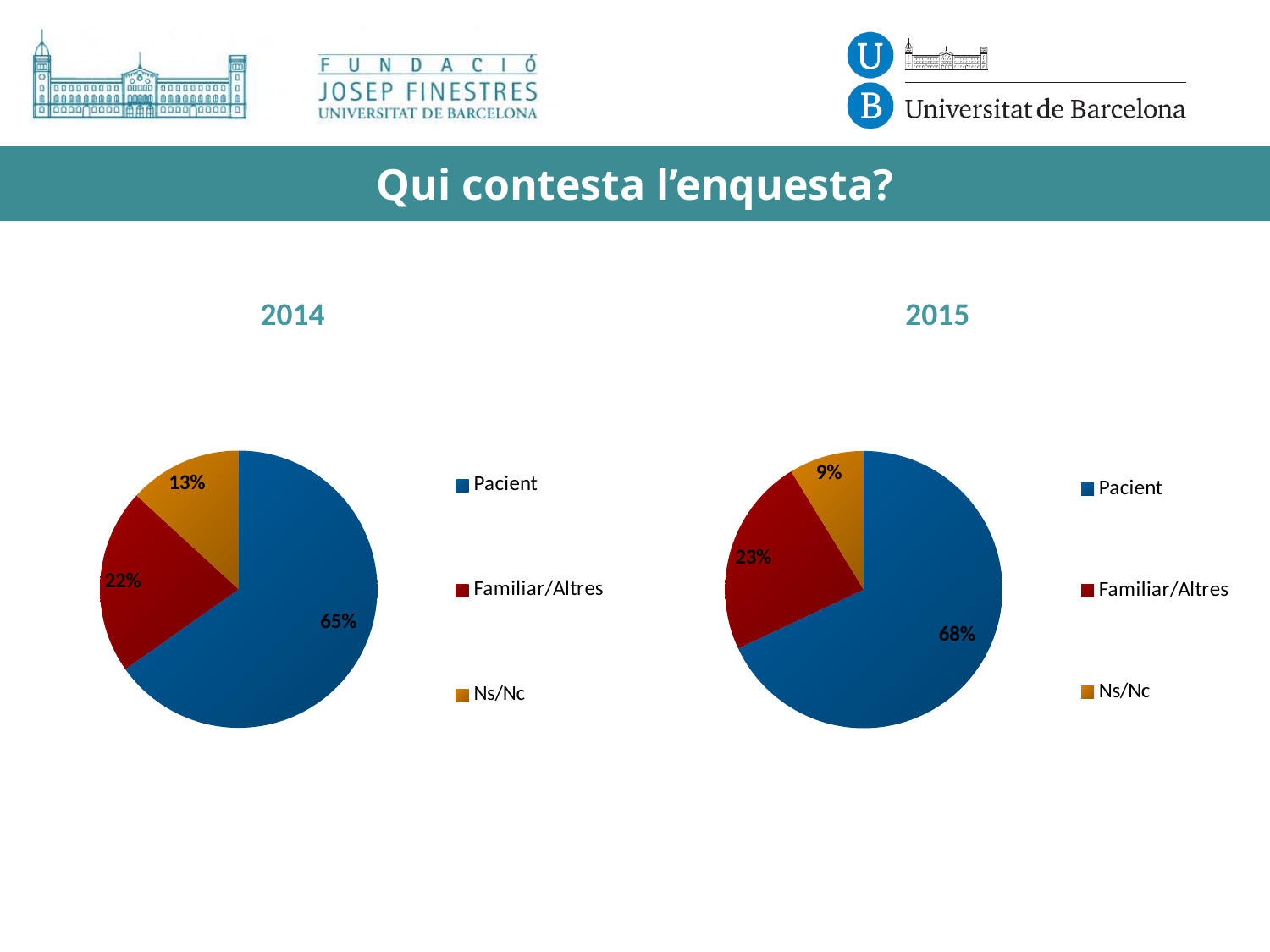
In the 2014 chart, what share of respondents is Ns/Nc? 13% How many categories does the 2015 chart show? 3 In the 2015 chart, what share of respondents is Ns/Nc? 9% Is the Ns/Nc share larger in the 2014 chart or the 2015 chart? 2014 In the 2014 chart, what is the difference between the Familiar/Altres share and the Ns/Nc share? 9% In the 2014 chart, which category has the smallest slice? Ns/Nc What kind of chart is used for the 2014 data? Pie chart In the 2014 chart, what share of respondents is Pacient? 65% What is the difference between the Pacient share in the 2015 chart and the Pacient share in the 2014 chart? 3% In the 2014 chart, which colour represents Familiar/Altres? Red In the 2015 chart, what share of respondents is Familiar/Altres? 23% In the 2015 chart, which category has the largest slice? Pacient